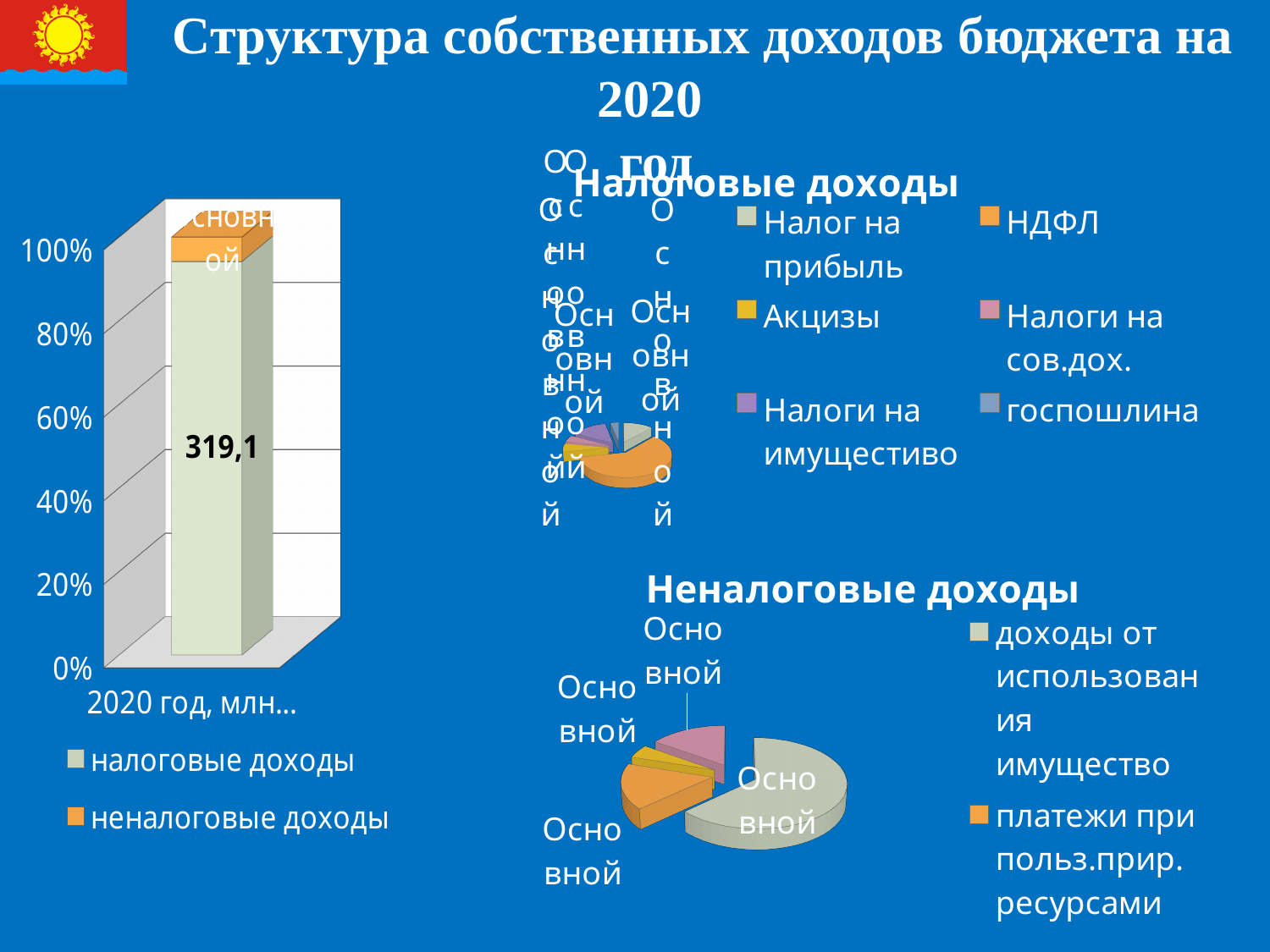
In the 'Неналоговые доходы' pie chart, which category has the largest slice? доходы от использования имущество What kind of chart is the chart titled 'Налоговые доходы'? pie chart In the bar chart on the left, which series takes the larger share of the bar: налоговые доходы or неналоговые доходы? налоговые доходы In the bar chart on the left, is the share of налоговые доходы greater or less than 80%? greater In the 'Неналоговые доходы' chart, which legend entry is shown in orange? платежи при польз.прир. ресурсами What kind of chart is the chart on the left side of the slide? bar chart In the 'Налоговые доходы' pie chart, which category has the largest slice? НДФЛ In the bar chart on the left, is the share of неналоговые доходы greater or less than 20%? less In the bar chart on the left, what value is printed on the налоговые доходы segment? 319,1 How many series does the legend of the bar chart on the left list? 2 How many entries does the legend of the 'Налоговые доходы' chart list? 6 How many categories are shown on the x axis of the bar chart on the left? 1